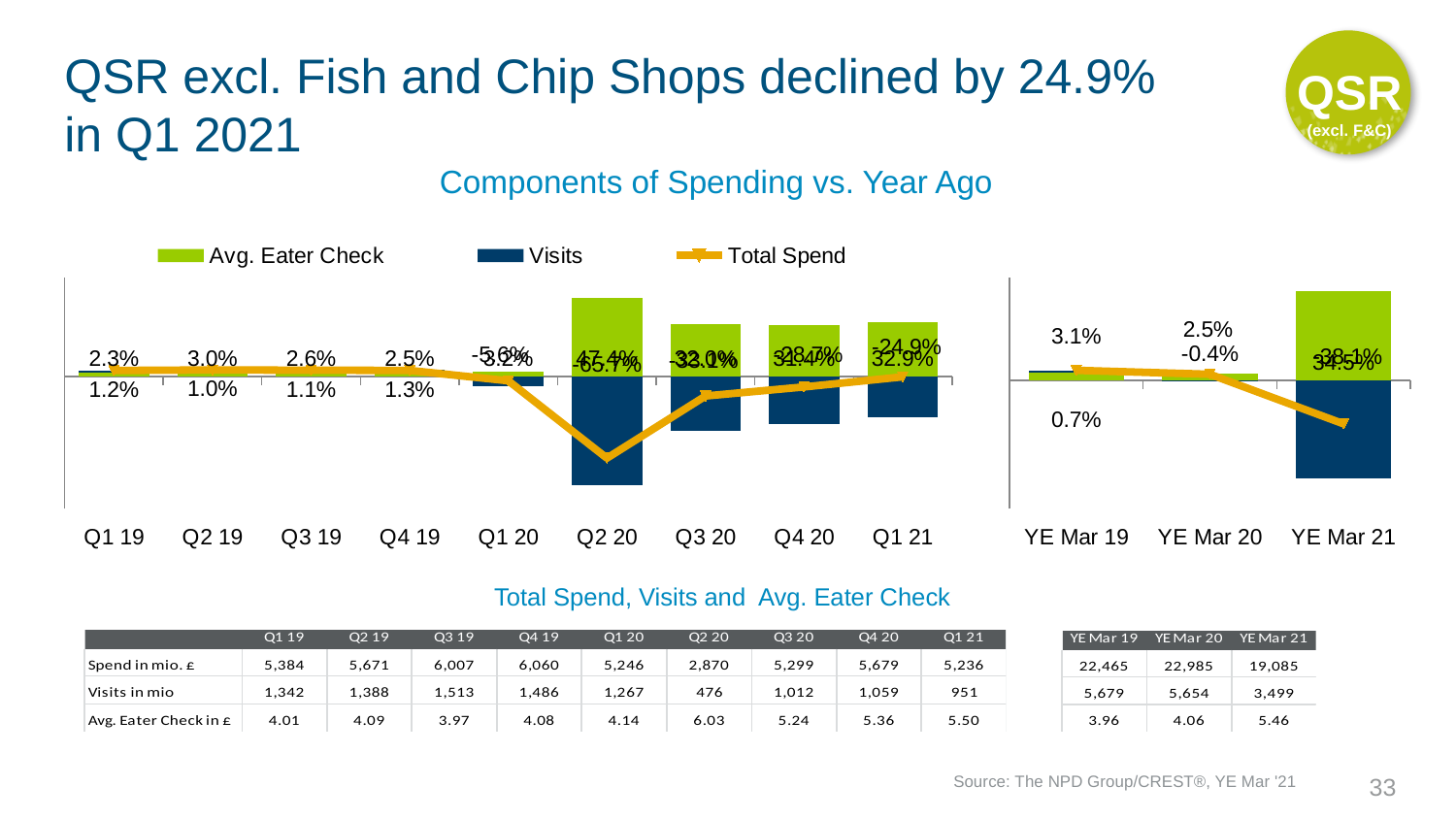
In the left quarterly chart, how many quarters are shown on the x axis? 9 In the right chart, what is the Visits value for YE Mar 20? -0.4% In the right chart (YE Mar 19 to YE Mar 21), how many categories are shown on the x axis? 3 In the left quarterly chart, which quarter has the lowest Visits value? Q2 20 In the left quarterly chart, does the Total Spend line rise or fall from Q4 19 to Q2 20? Falls In the right chart, what is the Avg. Eater Check value for YE Mar 19? 3.1% How many series does the legend of the 'Components of Spending vs. Year Ago' chart list? 3 In the left quarterly chart, which of the 2019 quarters (Q1 19 to Q4 19) has the highest Avg. Eater Check value? Q2 19 In the left quarterly chart, what is the Visits value for Q4 19? 1.3% In the left quarterly chart, is the Visits value larger for Q1 19 or Q2 19? Q1 19 What kind of chart is the left chart under 'Components of Spending vs. Year Ago'? Combination bar and line chart In the left quarterly chart, what is the Avg. Eater Check value for Q2 19? 3.0%